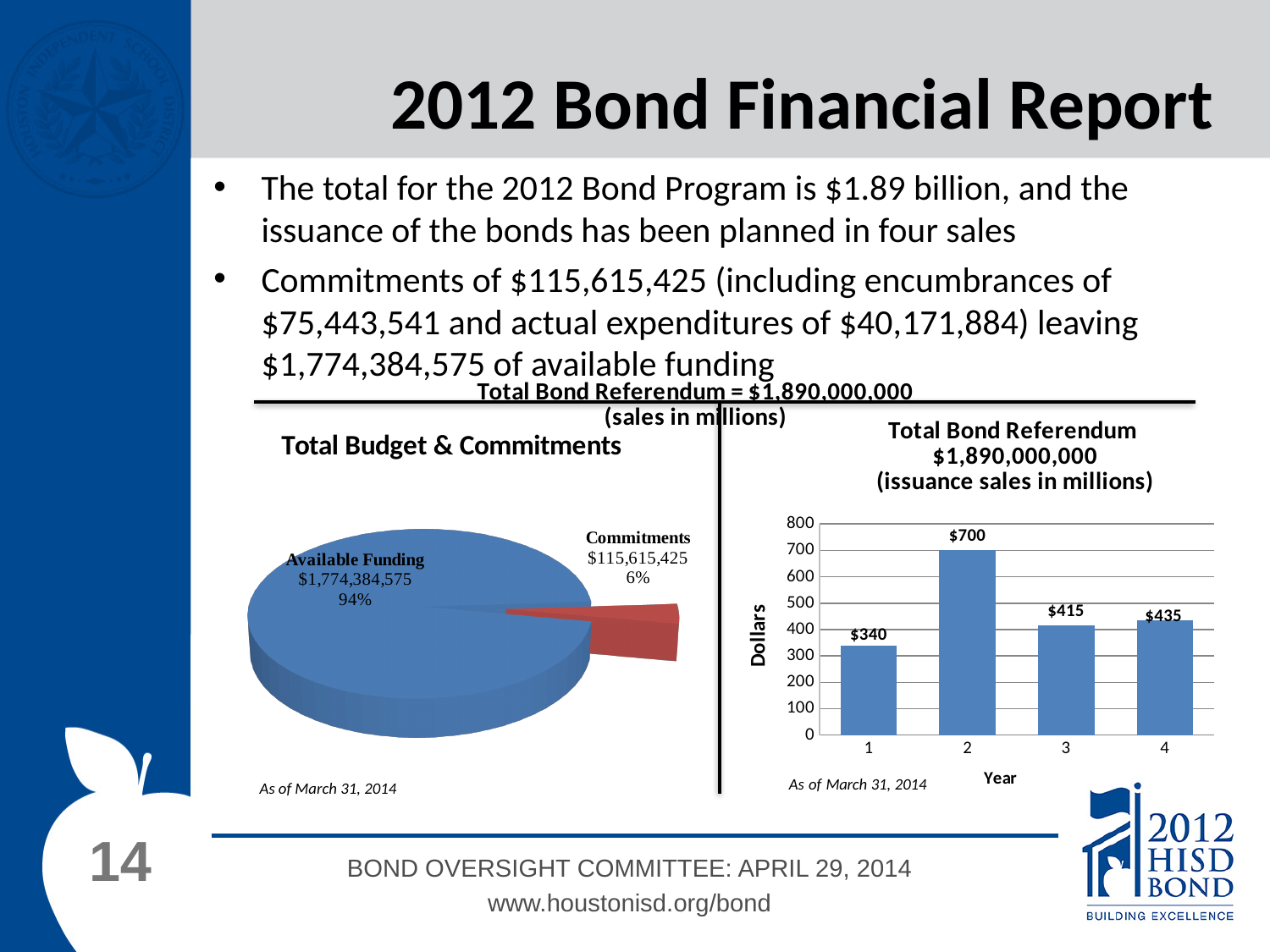
What kind of chart is the Total Bond Referendum chart on the right? Bar chart In the Total Bond Referendum bar chart, which year has the highest issuance sale? 2 In the Total Bond Referendum bar chart, what is the value for Year 2? $700 In the Total Budget & Commitments pie chart, what share does Available Funding represent? 94% In the Total Budget & Commitments pie chart, what is the value for Commitments? $115,615,425 In the Total Bond Referendum bar chart, how many years are shown on the x axis? 4 In the Total Bond Referendum bar chart, which year has the lowest issuance sale? 1 What kind of chart is the Total Budget & Commitments chart on the left? Pie chart In the Total Bond Referendum bar chart, what is the value for Year 1? $340 In the Total Bond Referendum bar chart, what is the difference between the values for Year 2 and Year 1? $360 In the Total Bond Referendum bar chart, which is larger, the value for Year 3 or Year 4? Year 4 What is the label on the y axis of the Total Bond Referendum bar chart? Dollars